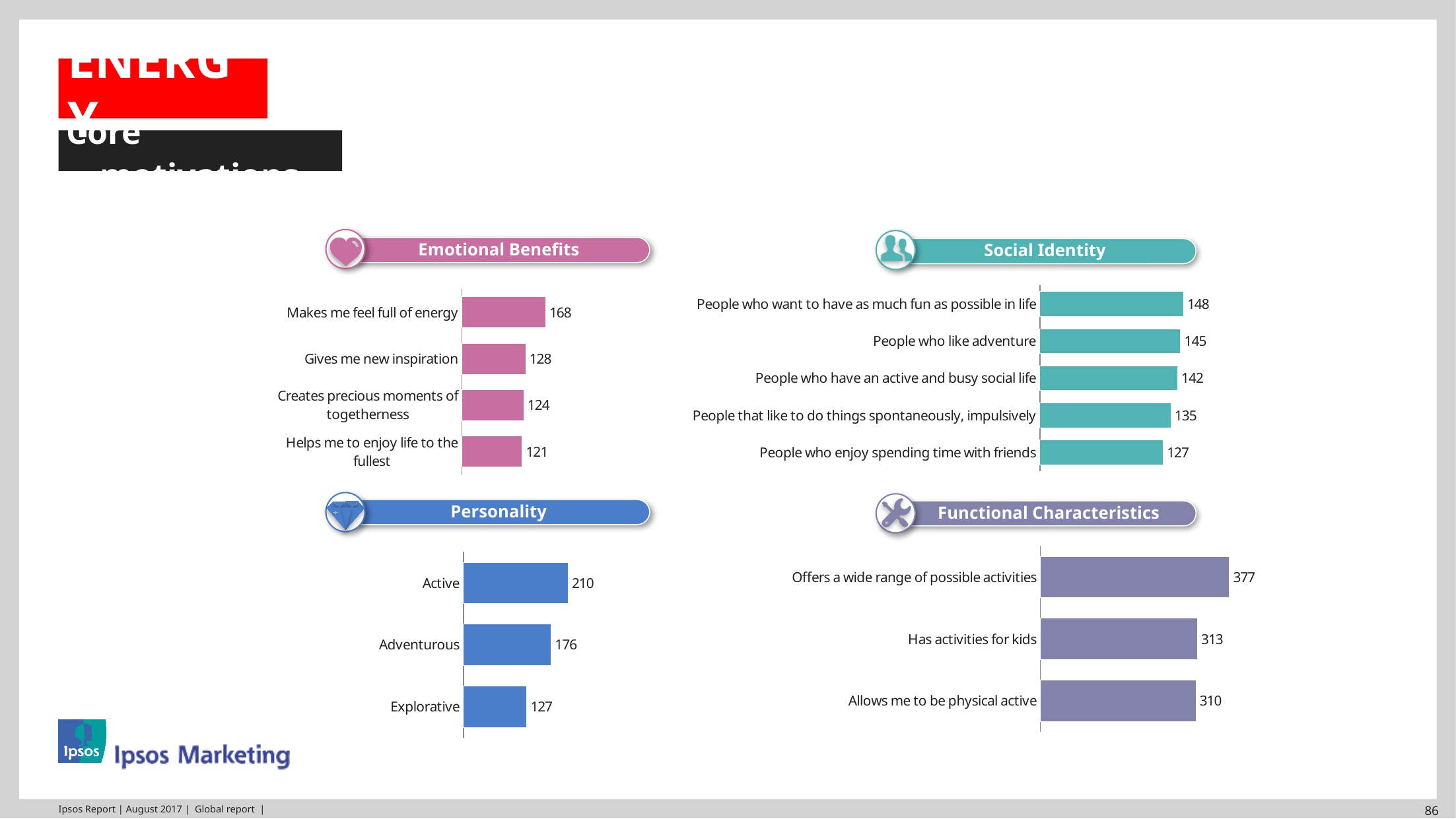
In the Personality chart, which is larger, Adventurous or Explorative? Adventurous In the Social Identity chart, what is the value for "People who like adventure"? 145 In the Social Identity chart, how many categories are shown? 5 In the Functional Characteristics chart, what is the difference between "Offers a wide range of possible activities" and "Allows me to be physical active"? 67 In the Emotional Benefits chart, what is the value for "Makes me feel full of energy"? 168 How many charts are shown on the slide? 4 In the Functional Characteristics chart, what is the value for "Has activities for kids"? 313 In the Emotional Benefits chart, which category has the lowest value? Helps me to enjoy life to the fullest In the Social Identity chart, which category has the highest value? People who want to have as much fun as possible in life What kind of chart is the Personality chart? Bar chart In the Personality chart, what is the difference between the values for Active and Explorative? 83 In the Functional Characteristics chart, which category has the highest value? Offers a wide range of possible activities